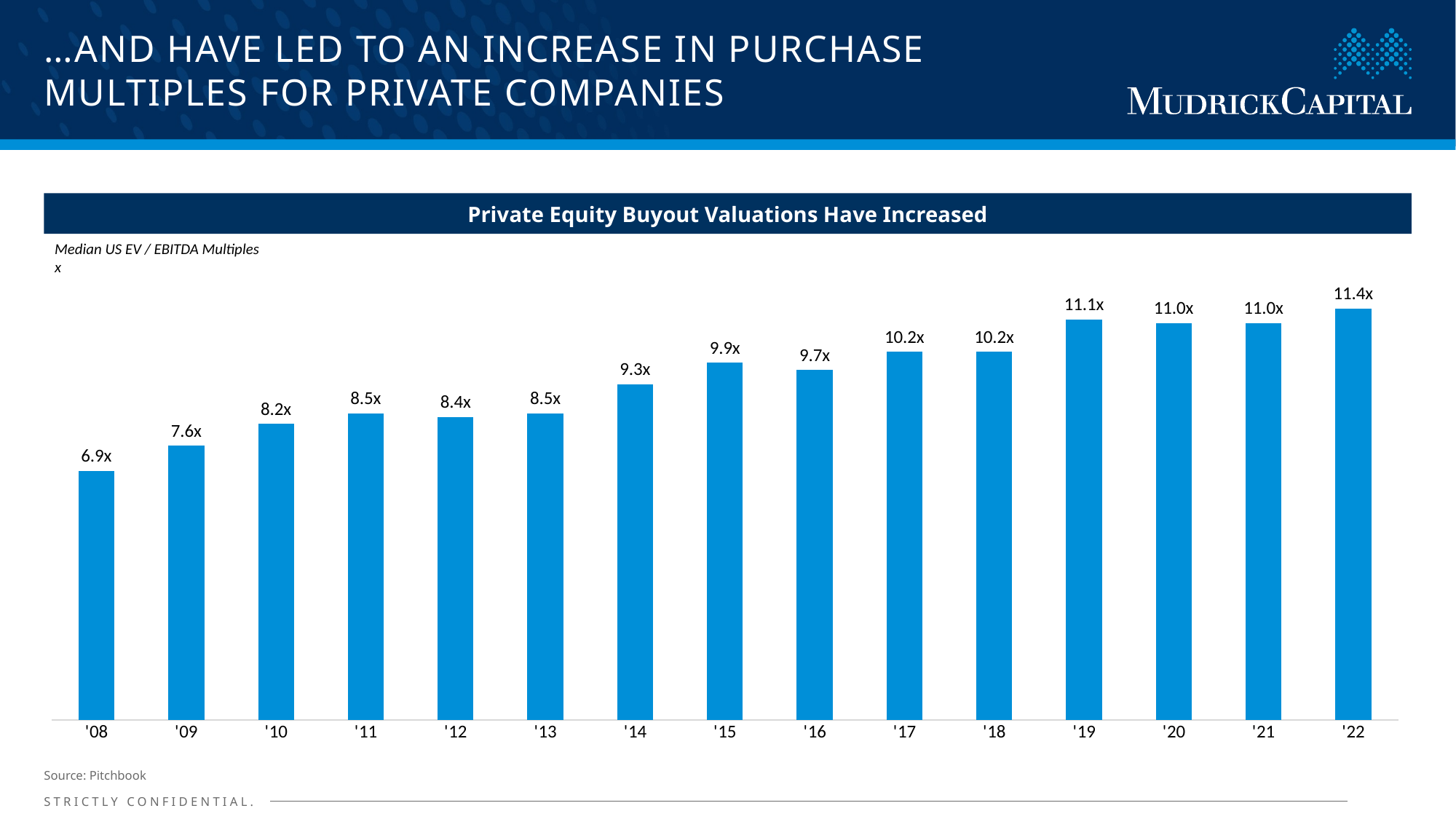
What kind of chart is this? Bar chart Which year has the highest multiple? '22 What is the title of the chart? Private Equity Buyout Valuations Have Increased What is the difference between the multiples for '22 and '08? 4.5x What is the median US EV / EBITDA multiple shown for '08? 6.9x How many years are shown on the x axis? 15 Which year has the lowest multiple? '08 What is the value shown for '19? 11.1x Which is larger, the multiple for '12 or the multiple for '13? '13 What is the difference between the multiples for '16 and '15? 0.2x What is the value shown for '14? 9.3x Do the multiples generally rise or fall from '08 to '22? Rise